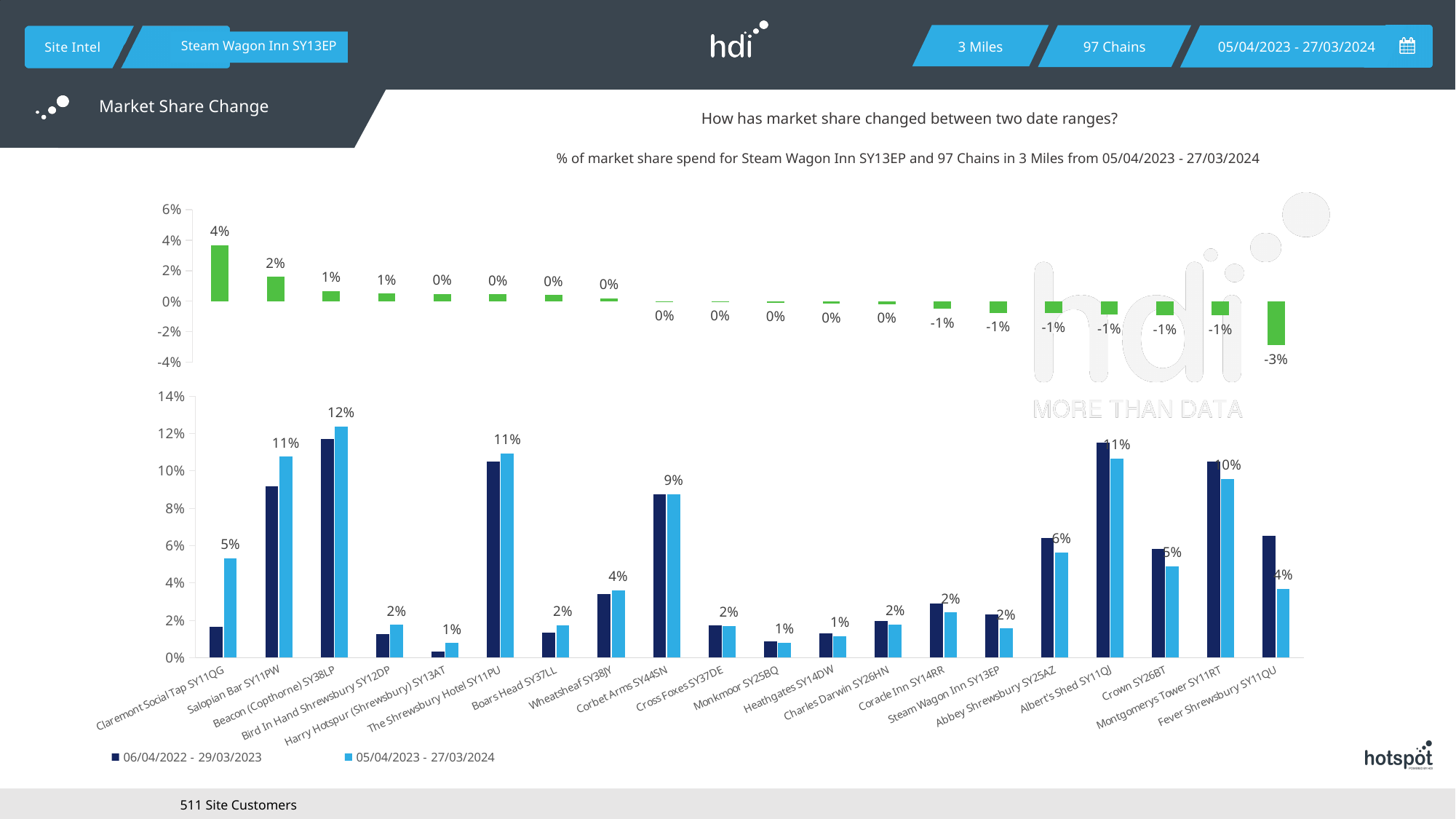
How many categories are shown on the x axis of the bottom chart? 20 In the bottom chart, which category has the highest labelled value in the 05/04/2023 - 27/03/2024 series? Beacon (Copthorne) SY38LP How many series does the legend of the bottom chart list? 2 In the bottom chart, which is larger in the 05/04/2023 - 27/03/2024 series: Salopian Bar SY11PW or Claremont Social Tap SY11QG? Salopian Bar SY11PW In the top chart (market share change), what is the value for Fever Shrewsbury SY11QU? -3% In the top chart (market share change), which category has the highest value? Claremont Social Tap SY11QG In the bottom chart, what is the labelled value for Corbet Arms SY44SN in the 05/04/2023 - 27/03/2024 series? 9% In the bottom chart, what is the difference between the labelled 05/04/2023 - 27/03/2024 values for Beacon (Copthorne) SY38LP and Claremont Social Tap SY11QG? 7% In the bottom chart, is the 06/04/2022 - 29/03/2023 value for Albert's Shed SY11QJ greater or less than 10%? greater In the bottom chart, what is the labelled value for Beacon (Copthorne) SY38LP in the 05/04/2023 - 27/03/2024 series? 12% In the top chart (market share change), what is the value for Claremont Social Tap SY11QG? 4% In the top chart (market share change), which category has the lowest value? Fever Shrewsbury SY11QU